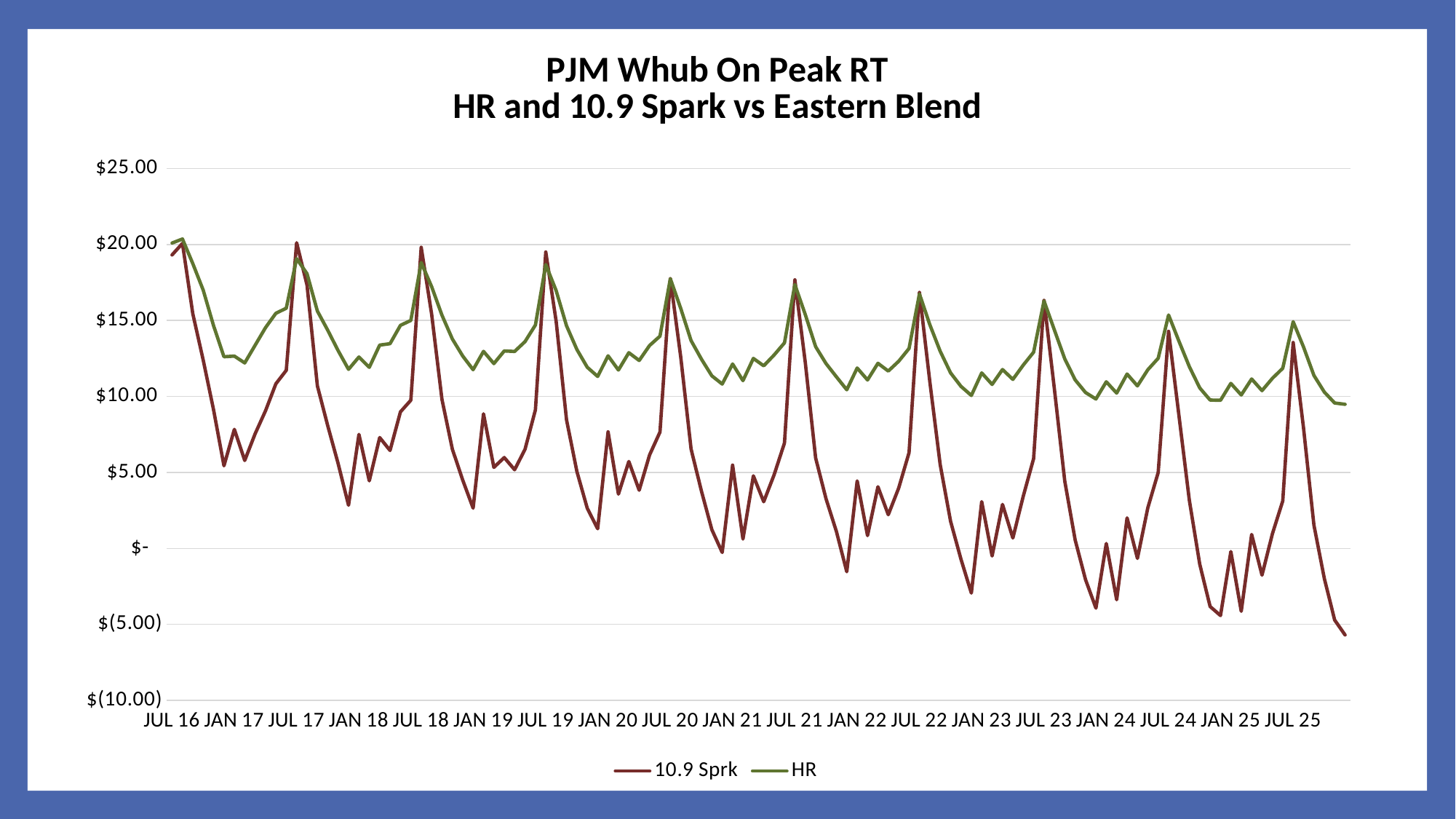
Is the value of the 10.9 Sprk series at JUL 17 greater or less than $15.00? greater Do the seasonal peaks of the HR series generally rise or fall from JUL 16 to JUL 25? fall What kind of chart is shown on the slide? line chart What is the title of the chart? PJM Whub On Peak RT HR and 10.9 Spark vs Eastern Blend Which series reaches the lowest value anywhere on the chart? 10.9 Sprk What are the two series named in the legend? 10.9 Sprk and HR Is the value of the HR series at JAN 17 greater or less than $10.00? greater Is the value of the HR series at JAN 20 greater or less than $10.00? greater At JAN 25, which series has the higher value, 10.9 Sprk or HR? HR How many series does the legend list? 2 At JAN 23, which series has the higher value, 10.9 Sprk or HR? HR